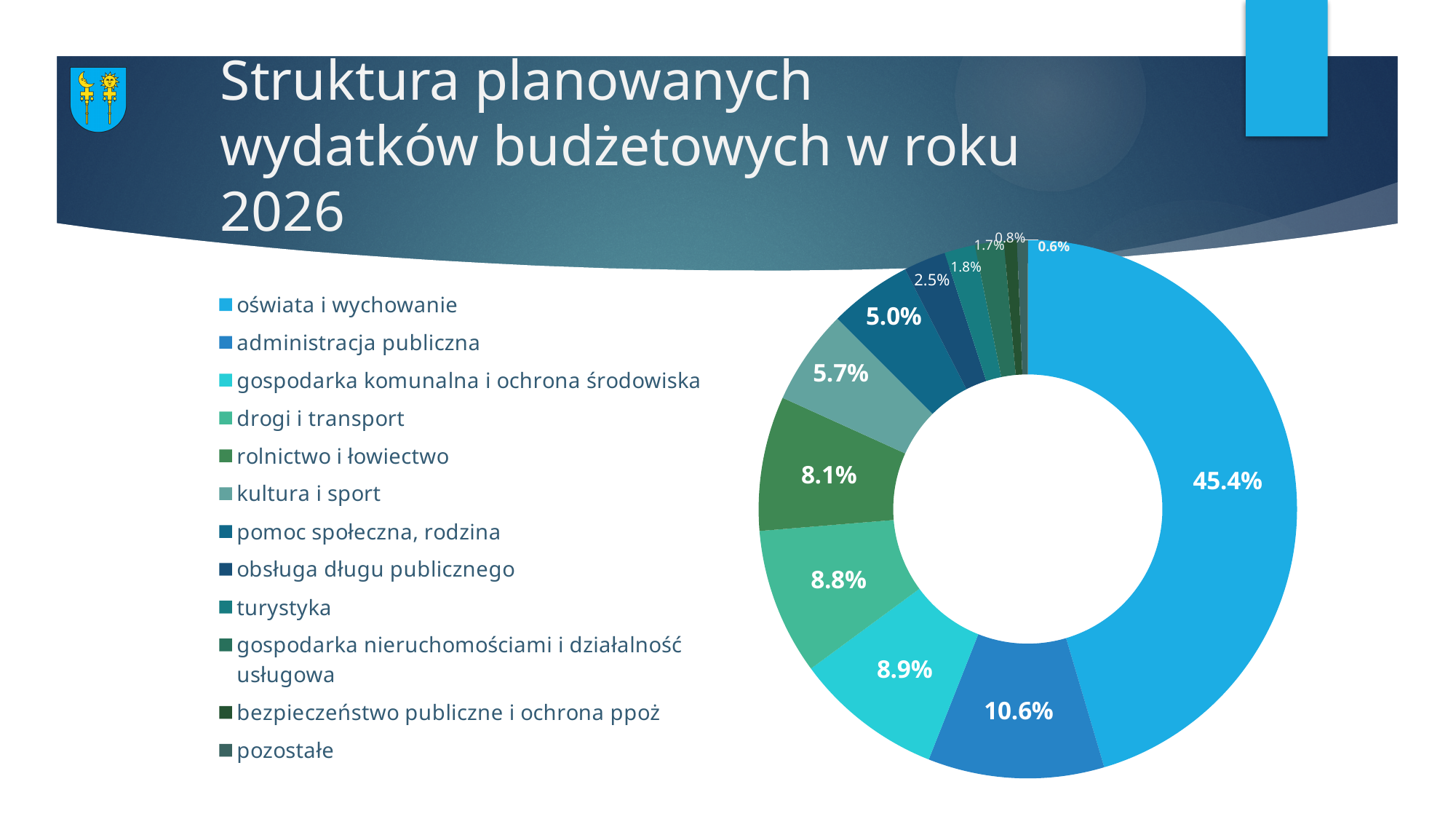
What kind of chart is shown on the slide? Doughnut (pie) chart How many categories does the legend list? 12 What percentage is shown for rolnictwo i łowiectwo? 8.1% What percentage is shown for obsługa długu publicznego? 2.5% What is the title of the slide containing the chart? Struktura planowanych wydatków budżetowych w roku 2026 What share of planned 2026 budget expenditure goes to oświata i wychowanie? 45.4% Which category has the smallest share of planned expenditure? pozostałe What percentage is shown for pomoc społeczna, rodzina? 5.0% Which category has the largest share of planned expenditure? oświata i wychowanie What is the difference in percentage points between oświata i wychowanie and administracja publiczna? 34.8 percentage points Which has a larger share: kultura i sport or pomoc społeczna, rodzina? kultura i sport What percentage is shown for administracja publiczna? 10.6%